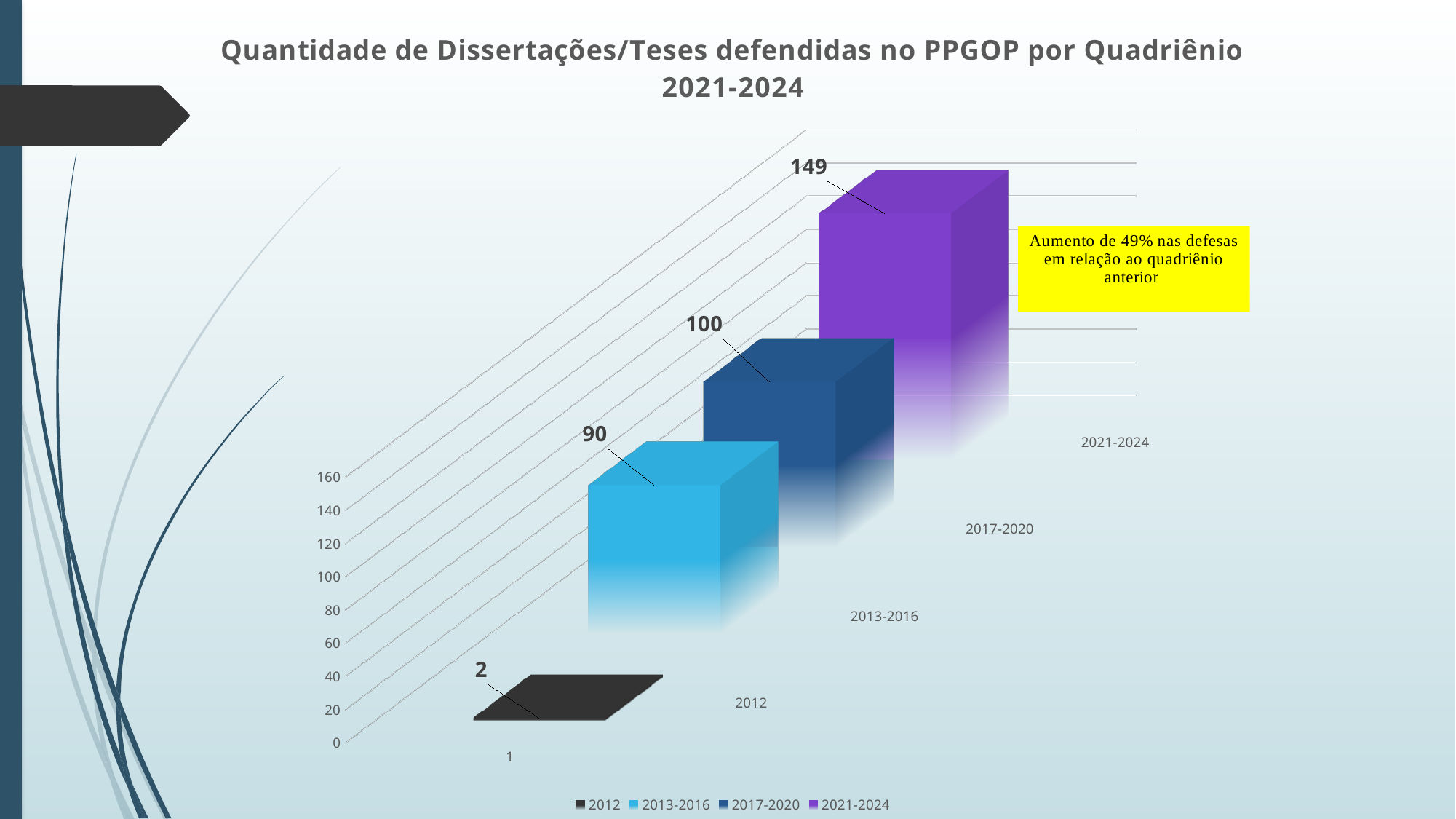
What is the difference between the values for 2021-2024 and 2017-2020? 49 What is the value shown for 2017-2020? 100 What is the value shown for 2013-2016? 90 Which period has the lowest value? 2012 What kind of chart is shown on the slide? Bar chart Which is larger, the value for 2013-2016 or the value for 2017-2020? 2017-2020 Which period has the highest value? 2021-2024 How many series does the legend list? 4 What is the value shown for 2021-2024? 149 What percentage increase in defenses does the yellow annotation state relative to the previous quadrennium? 49% What is the difference between the values for 2017-2020 and 2013-2016? 10 What is the value shown for 2012? 2